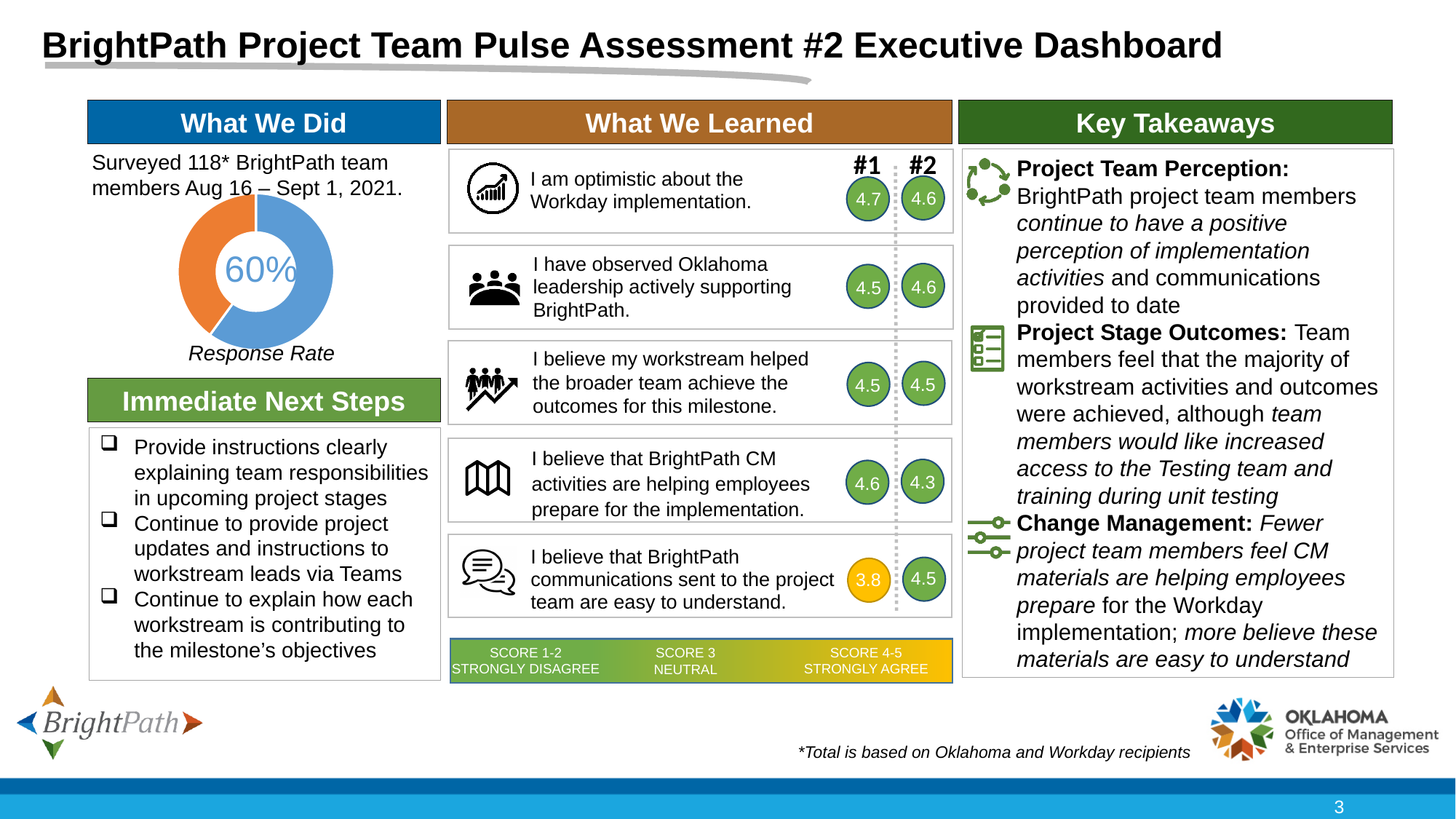
In the "What We Learned" score dashboard, which statement has the lowest #1 score? I believe that BrightPath communications sent to the project team are easy to understand In the "What We Learned" score dashboard, what is the difference between the #2 and #1 scores for the statement about BrightPath communications being easy to understand? 0.7 In the "What We Learned" score dashboard, what is the #1 score for "I believe that BrightPath communications sent to the project team are easy to understand"? 3.8 How many statements are scored in the "What We Learned" dashboard? 5 In the donut chart, which slice is larger, the blue one or the orange one? Blue In the "What We Learned" score dashboard, which statement has the highest #1 score? I am optimistic about the Workday implementation What type of chart is shown under "What We Did"? Donut (pie) chart What value is printed in the centre of the donut chart? 60% Is the blue slice of the donut chart greater or less than 50% of the whole? greater How many slices does the donut chart have? 2 What is the caption below the donut chart? Response Rate In the "What We Learned" score dashboard, what is the #2 score for "I am optimistic about the Workday implementation"? 4.6